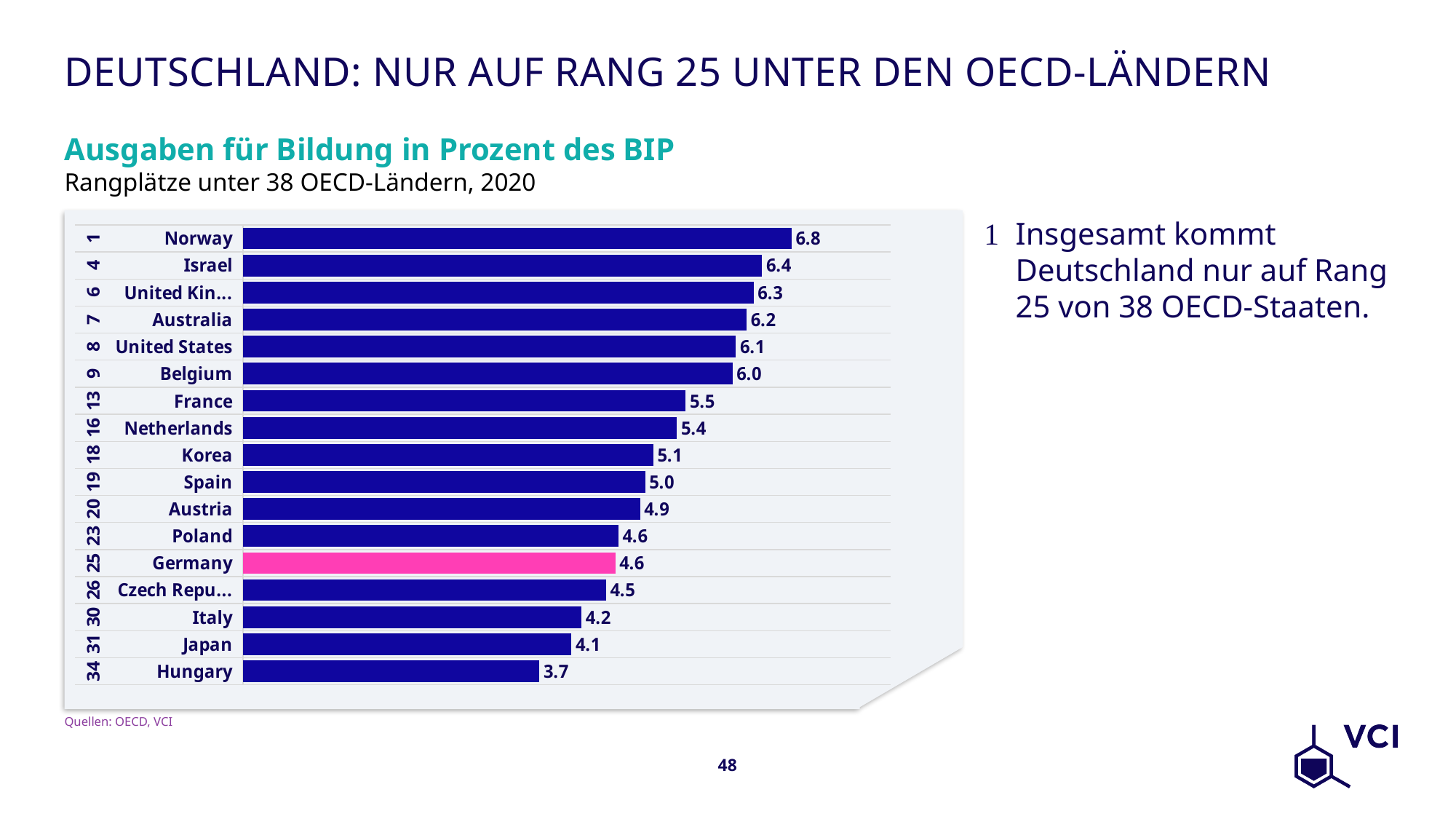
What kind of chart is this? Bar chart What is the value for Hungary? 3.7 Which country has the highest value? Norway What is the difference between the values for France and Italy? 1.3 How many countries are shown in the chart? 17 Which country has the lowest value? Hungary Which is larger, the value for Korea or the value for Japan? Korea Which country's bar is highlighted in pink? Germany What is the value for Netherlands? 5.4 What is the value for Norway? 6.8 What is the difference between the values for Norway and Germany? 2.2 What is the value for Germany? 4.6